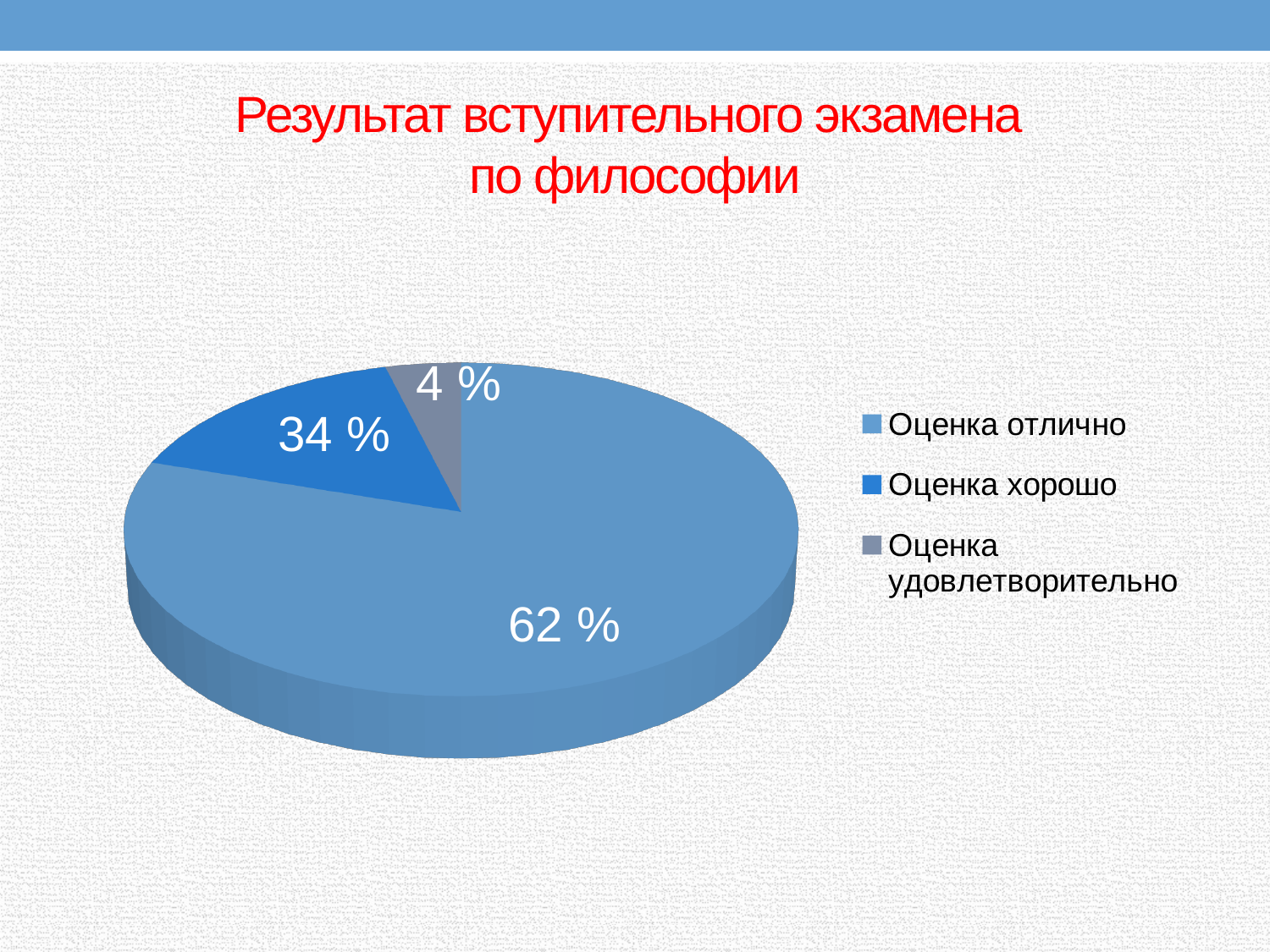
What is the difference in percentage points between "Оценка хорошо" and "Оценка удовлетворительно"? 30 What share of the pie is labelled "Оценка хорошо"? 34 % What is the title of the chart on the slide? Результат вступительного экзамена по философии What kind of chart is shown on the slide? Pie chart What share of the pie is labelled "Оценка удовлетворительно"? 4 % Which category has the largest slice of the pie? Оценка отлично How many slices does the pie chart have? 3 What is the difference in percentage points between "Оценка отлично" and "Оценка хорошо"? 28 Which category has the smallest slice of the pie? Оценка удовлетворительно Which is larger: the slice for "Оценка хорошо" or the slice for "Оценка удовлетворительно"? Оценка хорошо Which legend entry is shown in grey? Оценка удовлетворительно What share of the pie is labelled "Оценка отлично"? 62 %